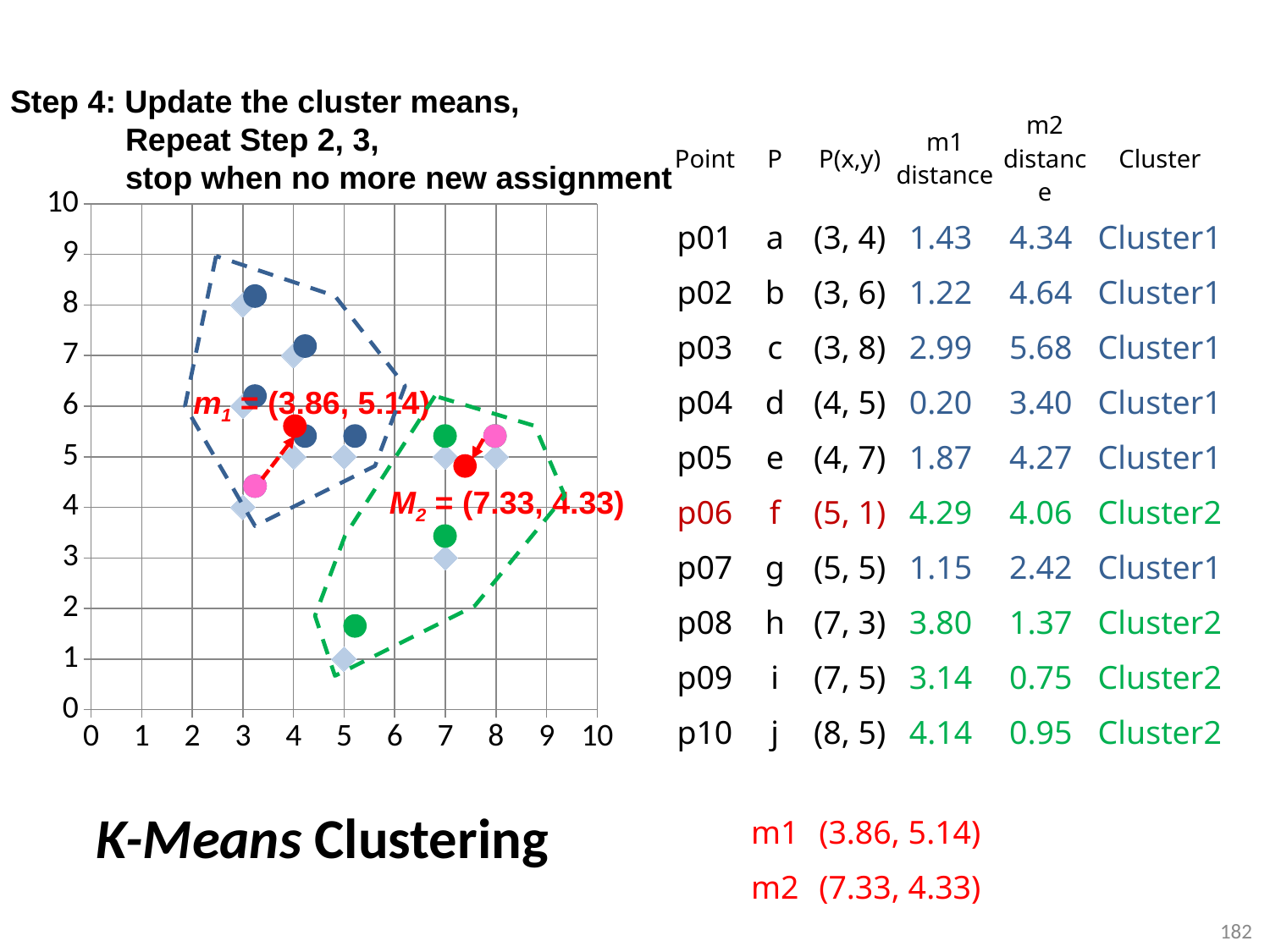
Which cluster mean has the larger x-coordinate, m1 or M2? M2 What is the maximum value shown on the x axis of the chart? 10 What kind of chart is shown on the slide? scatter chart What is the maximum value shown on the y axis of the chart? 10 How many light-blue diamond data points are plotted on the chart? 10 What are the coordinates of the cluster mean M2 as labelled on the chart? (7.33, 4.33) Is the y-coordinate of the lowest green point on the chart greater or less than 2? less Is the y-coordinate of the cluster mean M2 greater or less than 5? less What is the difference between the x-coordinates of M2 and m1? 3.47 Which cluster mean has the larger y-coordinate, m1 or M2? m1 What are the coordinates of the cluster mean m1 as labelled on the chart? (3.86, 5.14) What is the difference between the y-coordinates of m1 and M2? 0.81